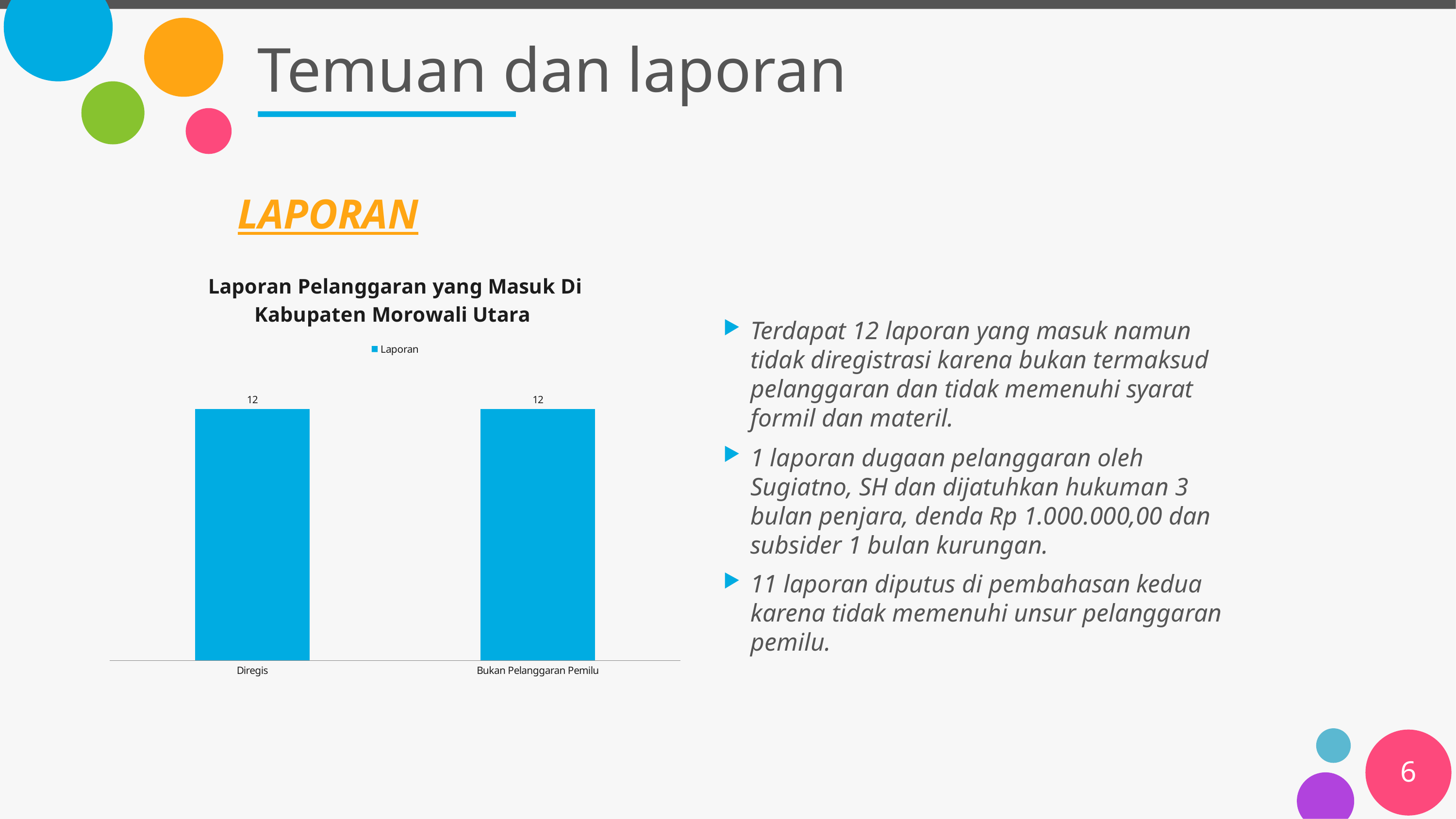
How many series does the chart legend list? 1 What is the value for Diregis in the chart? 12 What is the total of the values for Diregis and Bukan Pelanggaran Pemilu? 24 Are the values for Diregis and Bukan Pelanggaran Pemilu equal? Yes What is the value for Bukan Pelanggaran Pemilu in the chart? 12 What kind of chart is shown on the slide? Bar chart What is the name of the series listed in the chart legend? Laporan How many categories are shown on the x axis of the chart? 2 What is the title of the chart? Laporan Pelanggaran yang Masuk Di Kabupaten Morowali Utara What is the difference between the values for Diregis and Bukan Pelanggaran Pemilu? 0